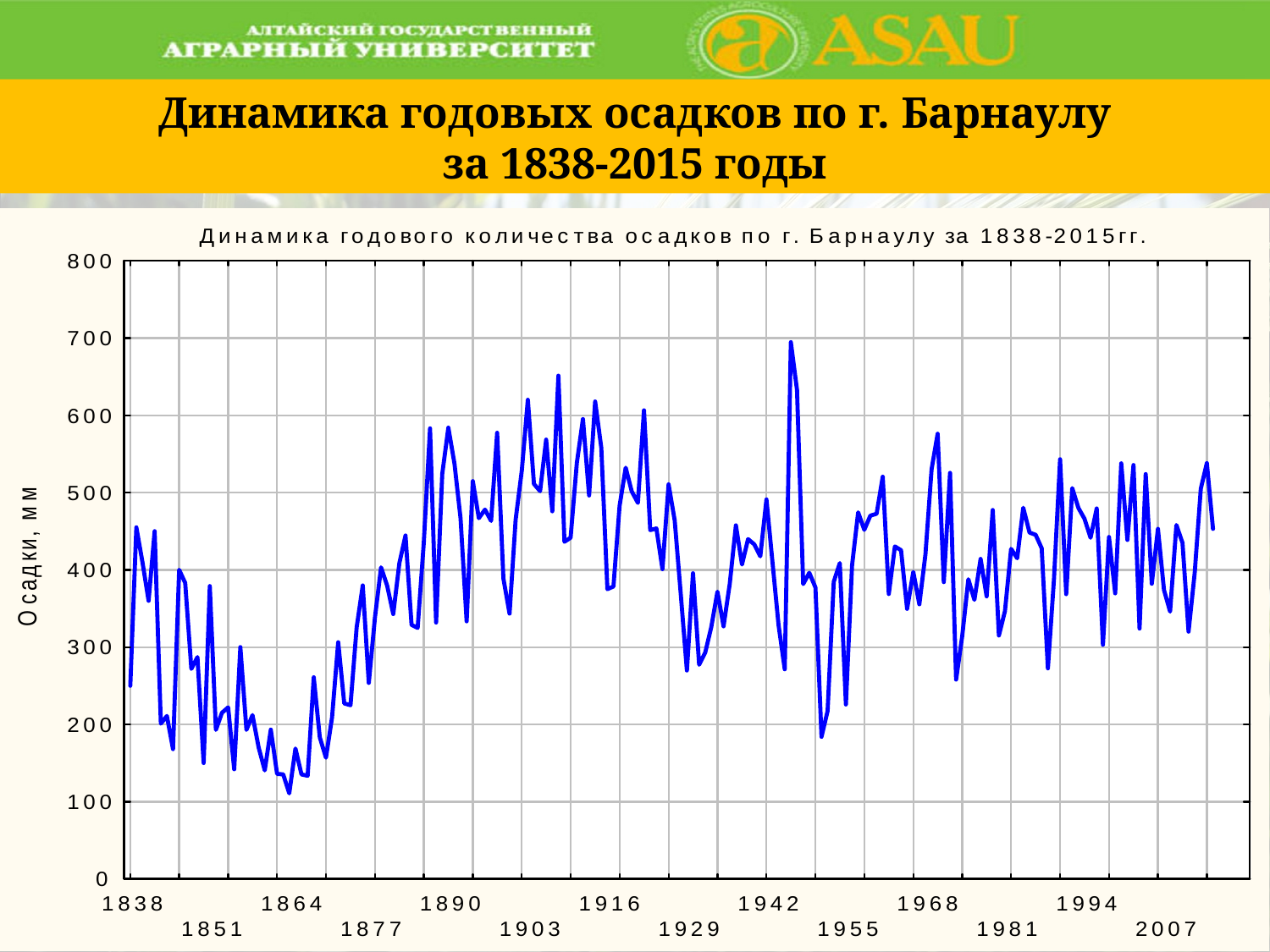
Which is larger, the value for 1838 or the value for 1864? 1838 Do the values generally rise or fall between 1864 and 1890? rise What is the highest tick value shown on the vertical axis? 800 What is the title of the chart? Динамика годового количества осадков по г. Барнаулу за 1838-2015гг. Is the highest value on the chart greater or less than 600? greater Is the lowest value on the chart greater or less than 200? less Do the values generally rise or fall between 1838 and 1864? fall Is the value for 1838 greater or less than 300? less What kind of chart is shown on the slide? line chart What is the label of the vertical axis? Осадки, мм